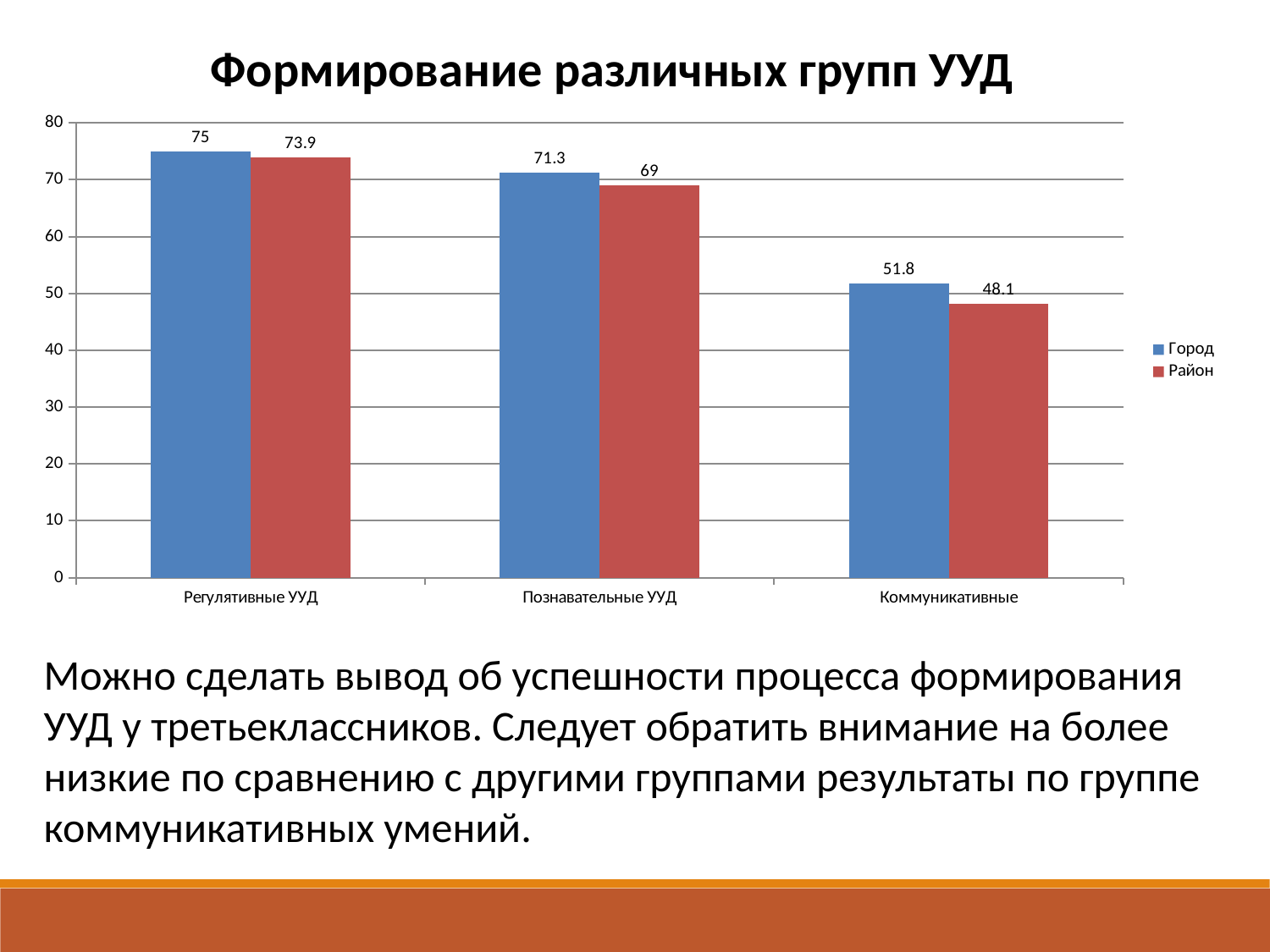
How many series does the legend list? 2 What is the value for Район in the Познавательные УУД category? 69 How many categories are shown on the x axis? 3 What kind of chart is shown on the slide? Bar chart What is the difference between Город and Район in the Познавательные УУД category? 2.3 What is the value for Город in the Регулятивные УУД category? 75 What is the difference between Город and Район in the Коммуникативные category? 3.7 What is the title of the chart? Формирование различных групп УУД Which is larger in the Регулятивные УУД category, Город or Район? Город Which category has the highest value for Район? Регулятивные УУД What is the value for Район in the Коммуникативные category? 48.1 Which category has the lowest value for Город? Коммуникативные